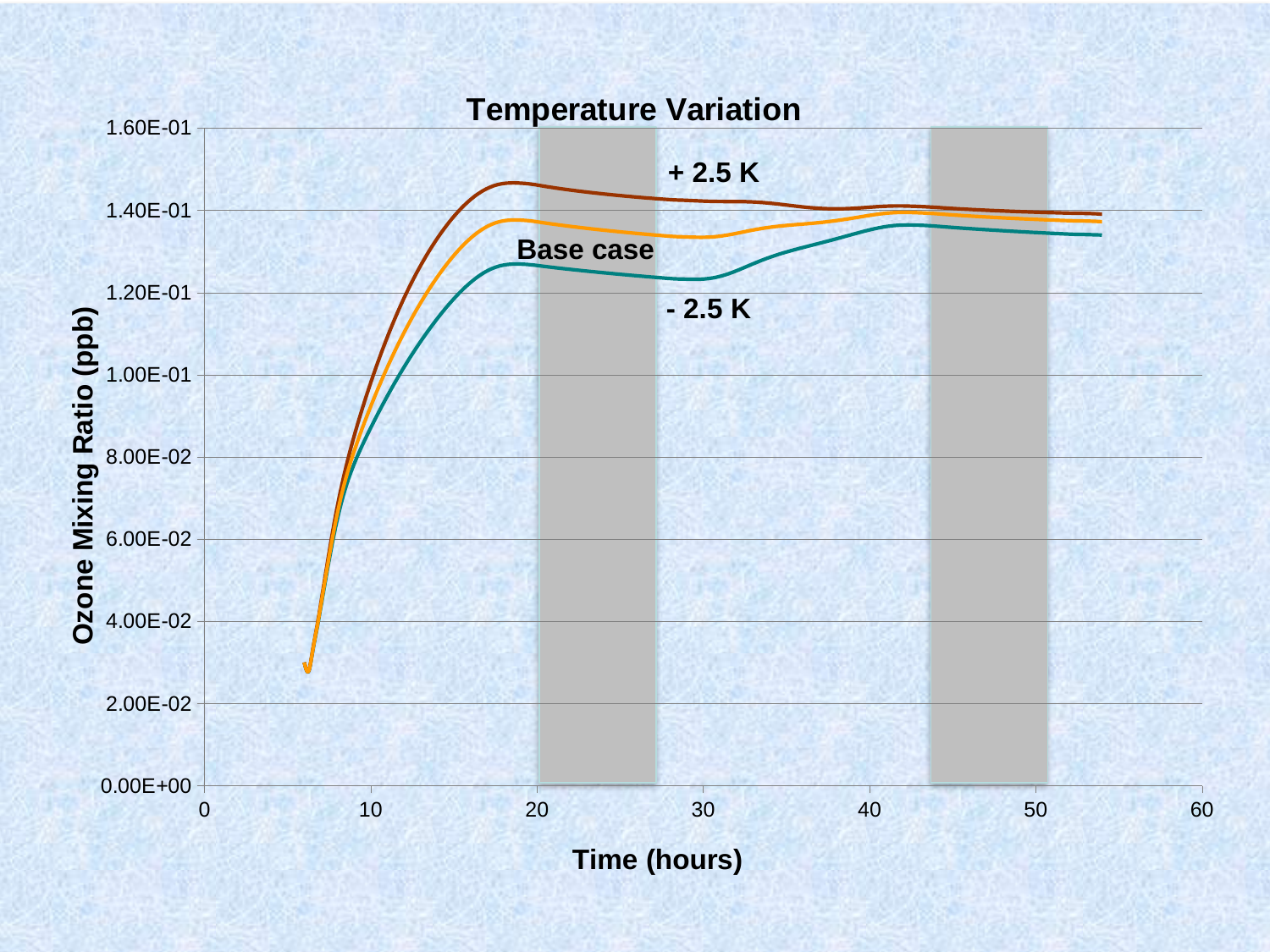
At 30 hours, which is larger: the + 2.5 K series or the - 2.5 K series? + 2.5 K Do the values of the - 2.5 K series rise or fall between 20 and 30 hours? fall How many series (lines) are plotted on the chart? 3 Is the peak value of the + 2.5 K series greater or less than 1.40E-01? greater Is the value of the - 2.5 K series at 30 hours greater or less than 1.40E-01? less Do the values of the Base case series rise or fall between 10 and 18 hours? rise Which series has the highest value at 20 hours? + 2.5 K What is the label of the y axis? Ozone Mixing Ratio (ppb) What is the title of the chart? Temperature Variation What kind of chart is shown on the slide? Line chart Which series has the lowest value at 30 hours? - 2.5 K